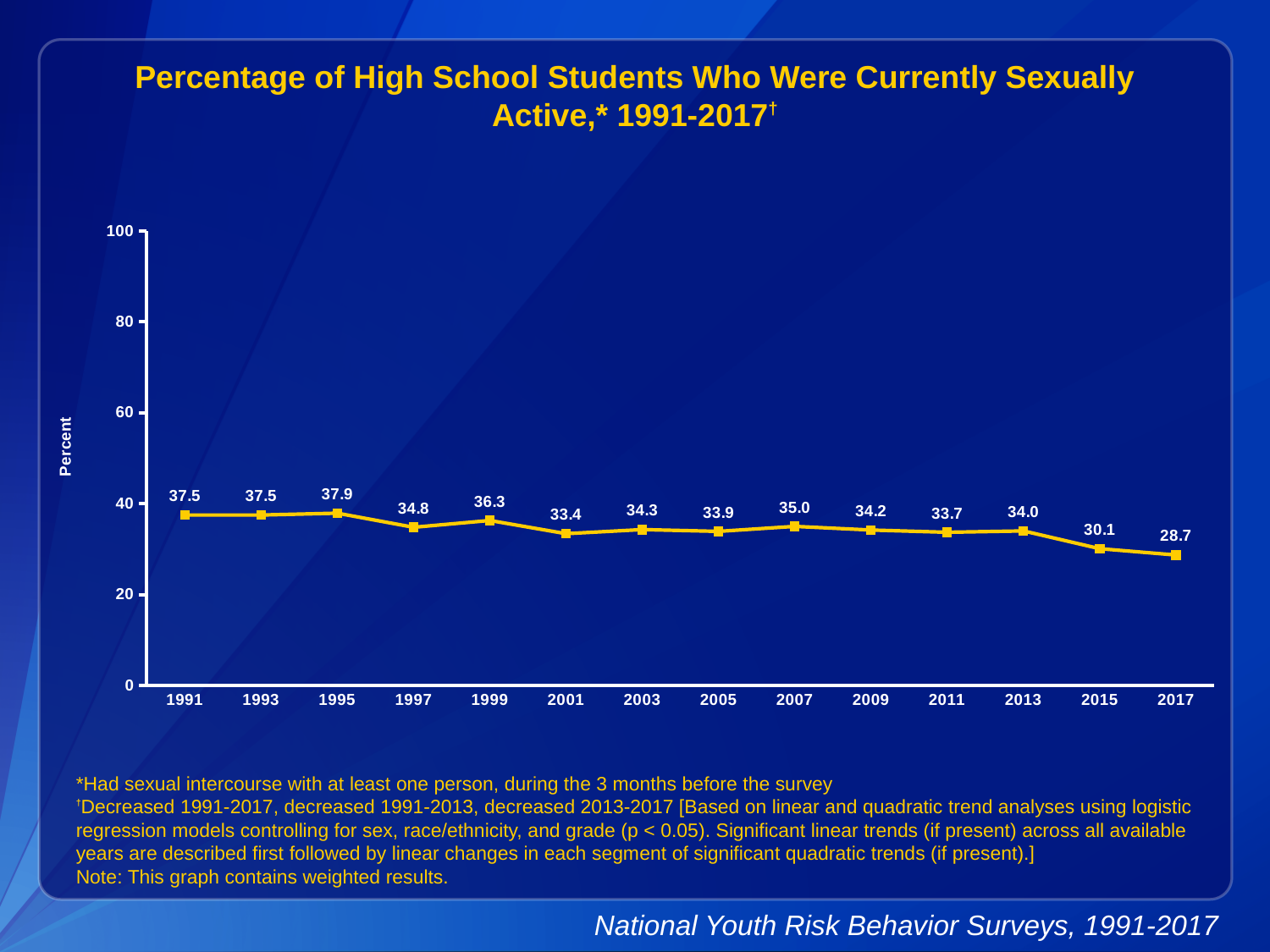
How many survey years are plotted on the chart? 14 What is the label on the y axis of the chart? Percent What was the percentage of high school students who were currently sexually active in 2017? 28.7 What was the percentage of high school students who were currently sexually active in 1991? 37.5 What value is shown for 2007? 35.0 What kind of chart is shown on the slide? line chart Which year has a higher value, 1999 or 2001? 1999 Which year has the lowest percentage of students who were currently sexually active? 2017 Overall, do the values rise or fall from 1991 to 2017? fall Is the value for 2015 greater or less than 40? less What is the difference between the 1991 value and the 2017 value? 8.8 Which year has the highest percentage of students who were currently sexually active? 1995